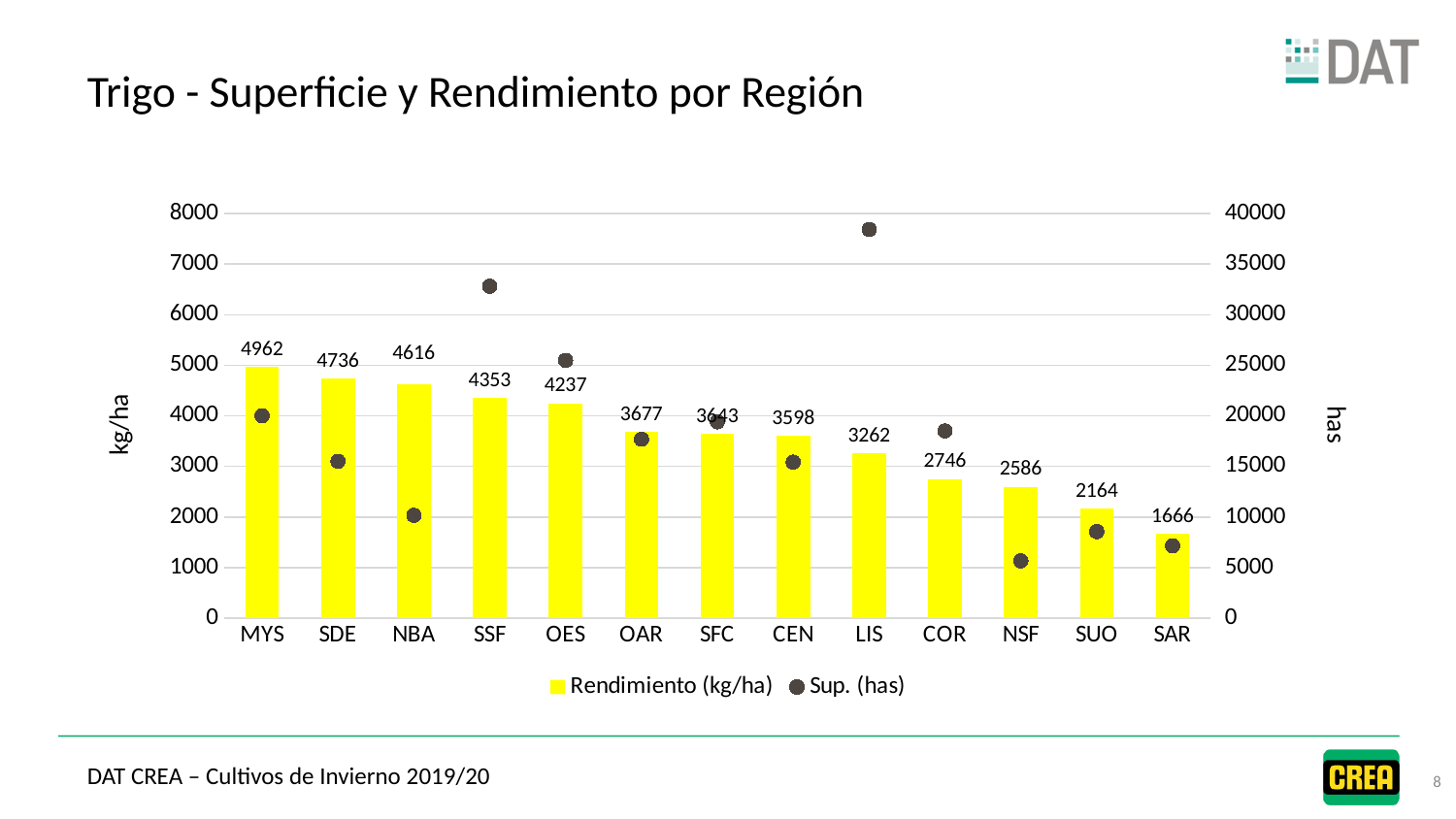
How many regions are shown on the x axis? 13 Which region has the highest Rendimiento (kg/ha)? MYS Is the Sup. (has) value for NSF greater or less than 10000? less How many series does the legend list? 2 Which region has the highest Sup. (has) value? LIS What is the title of the chart? Trigo - Superficie y Rendimiento por Región What is the Rendimiento (kg/ha) value for COR? 2746 What is the difference in Rendimiento (kg/ha) between SDE and NSF? 2150 What is the Rendimiento (kg/ha) value for MYS? 4962 Is the Sup. (has) value for SSF greater or less than 30000? greater Which region has the lowest Rendimiento (kg/ha)? SAR Which region has a higher Rendimiento (kg/ha), OES or LIS? OES